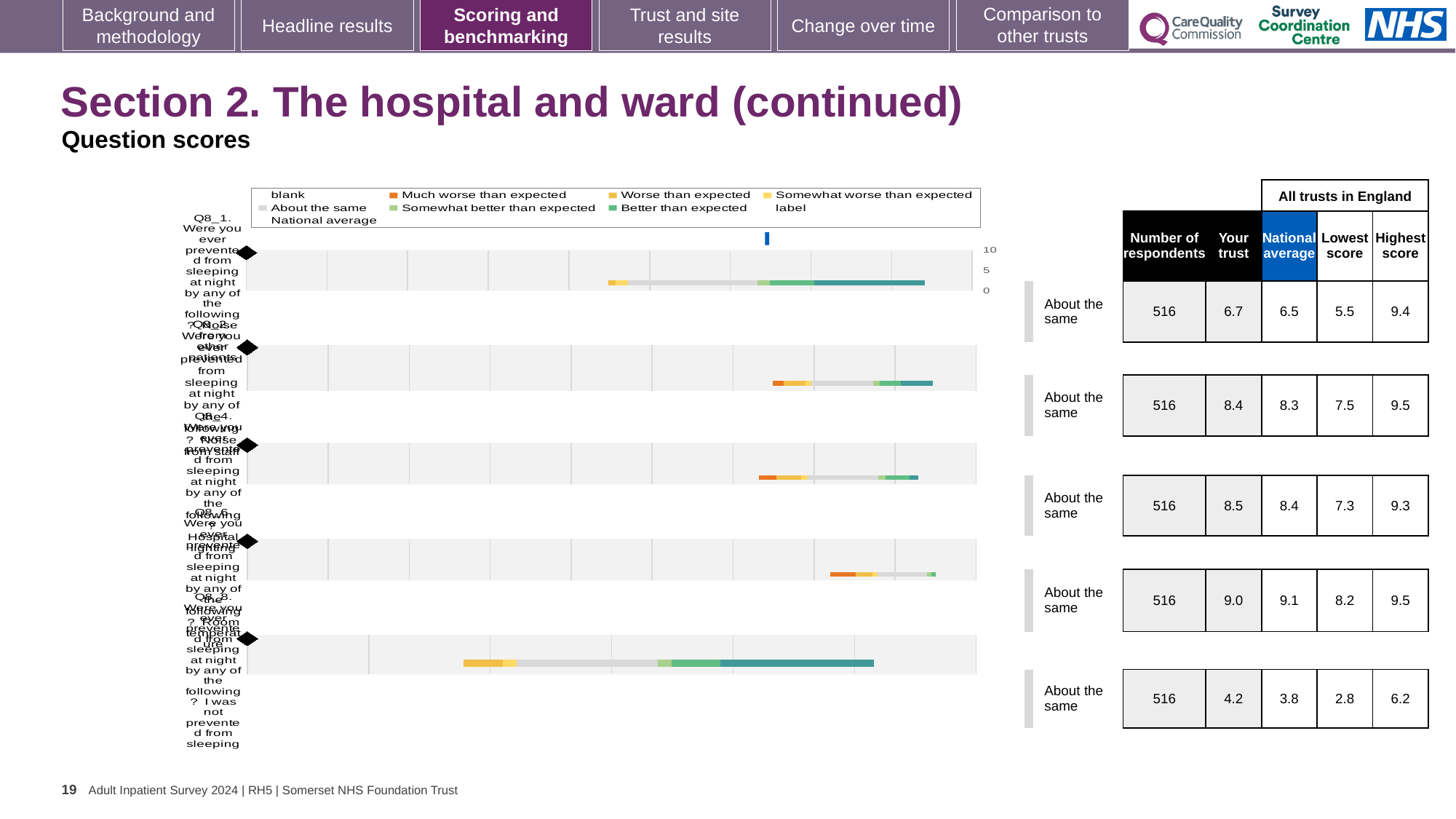
What benchmark category is shown for every question row in the chart? About the same Which question row has the lowest 'Your trust' score? the last row (Q8_8), 4.2 Which legend entry is shown in dark orange? Much worse than expected What is the 'Your trust' score for the first question row (Q8_1)? 6.7 What is the number of respondents shown for the last question row (Q8_8)? 516 Which question row has the highest 'Your trust' score? the fourth row (Q8_6), 9.0 Which legend entry is shown in dark teal? Better than expected For the fourth question row (Q8_6), which is larger: the 'Your trust' score or the national average? national average For the first question row (Q8_1), what is the difference between the highest score and the lowest score across all trusts in England? 3.9 What kind of chart is used to show the question scores on this slide? bar chart How many question rows (bars) are plotted in the chart? 5 What is the national average for the first question row (Q8_1)? 6.5